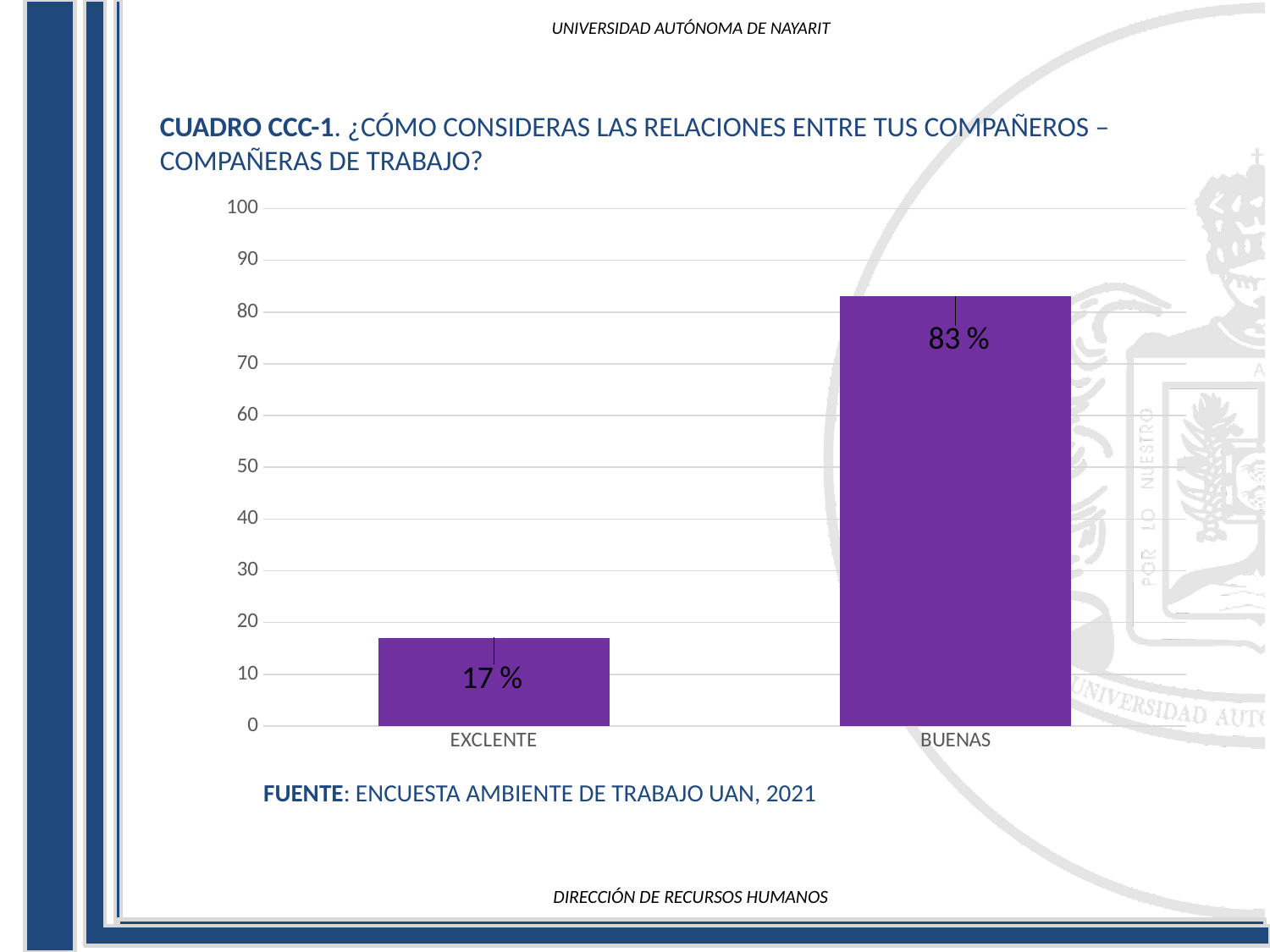
Is the value for EXCLENTE greater or less than 20? less What is the total of the two values shown in the chart? 100 % What is the difference between the values for BUENAS and EXCLENTE? 66 % What is the value for EXCLENTE? 17 % Which category has the lowest value? EXCLENTE Which is larger, the value for EXCLENTE or the value for BUENAS? BUENAS Which category has the highest value? BUENAS Is the value for BUENAS greater or less than 50? greater What is the value for BUENAS? 83 % How many categories are shown on the x axis? 2 What kind of chart is shown on the slide? bar chart What source is cited below the chart? ENCUESTA AMBIENTE DE TRABAJO UAN, 2021